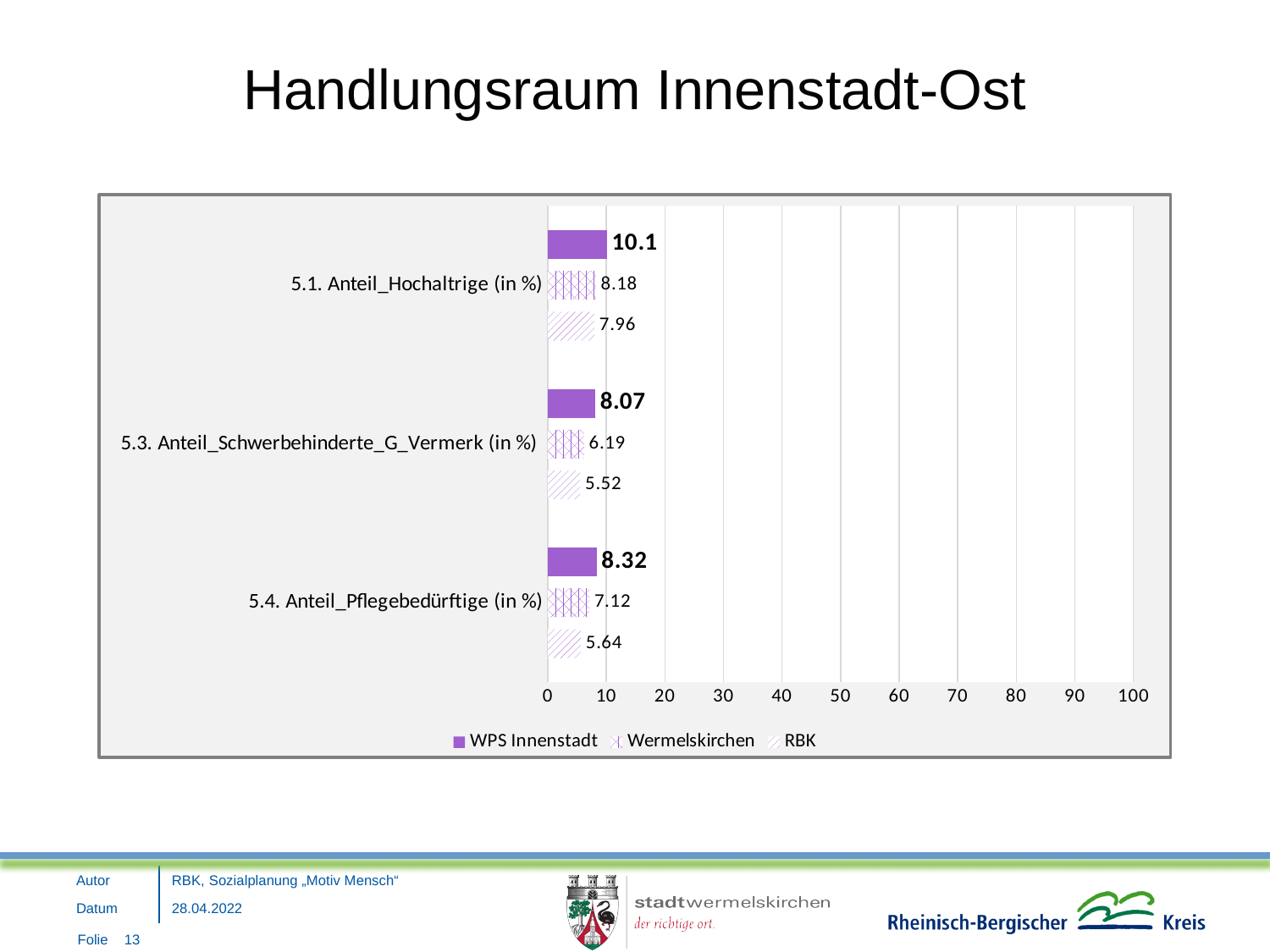
How many categories are shown on the chart? 3 What kind of chart is shown on the slide? bar chart Which category has the lowest value for RBK? 5.3. Anteil_Schwerbehinderte_G_Vermerk (in %) Which series is shown with solid purple bars? WPS Innenstadt In the category 5.3. Anteil_Schwerbehinderte_G_Vermerk (in %), which is larger: the value for Wermelskirchen or the value for RBK? Wermelskirchen What is the value for RBK in the category 5.3. Anteil_Schwerbehinderte_G_Vermerk (in %)? 5.52 What is the value for WPS Innenstadt in the category 5.1. Anteil_Hochaltrige (in %)? 10.1 What is the value for Wermelskirchen in the category 5.4. Anteil_Pflegebedürftige (in %)? 7.12 What is the difference between the WPS Innenstadt and RBK values in the category 5.4. Anteil_Pflegebedürftige (in %)? 2.68 Which category has the highest value for WPS Innenstadt? 5.1. Anteil_Hochaltrige (in %) Is the value for WPS Innenstadt in the category 5.1. Anteil_Hochaltrige (in %) greater or less than 10? greater How many series does the legend list? 3